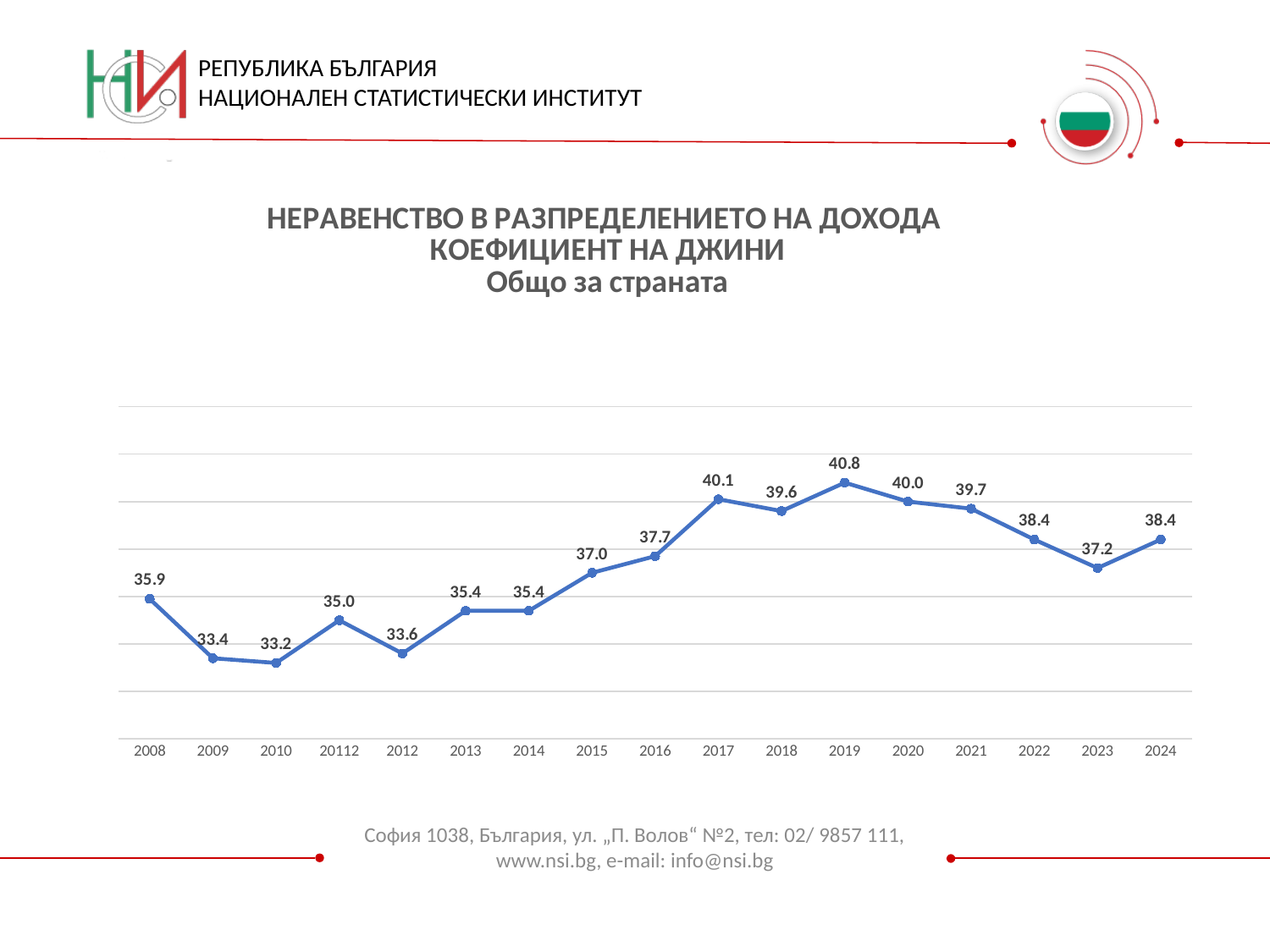
Does the value rise or fall from 2019 to 2023? fall What is the value plotted for 2019? 40.8 What is the difference between the values for 2019 and 2010? 7.6 Which is larger, the value for 2017 or the value for 2018? 2017 Which year has the lowest value on the chart? 2010 What is the value plotted for 2016? 37.7 What is the difference between the values for 2024 and 2023? 1.2 What is the value plotted for 2024? 38.4 How many years are plotted on the x axis? 17 What is the Gini coefficient value for 2008? 35.9 What type of chart is shown on the slide? line chart Which year has the highest value on the chart? 2019